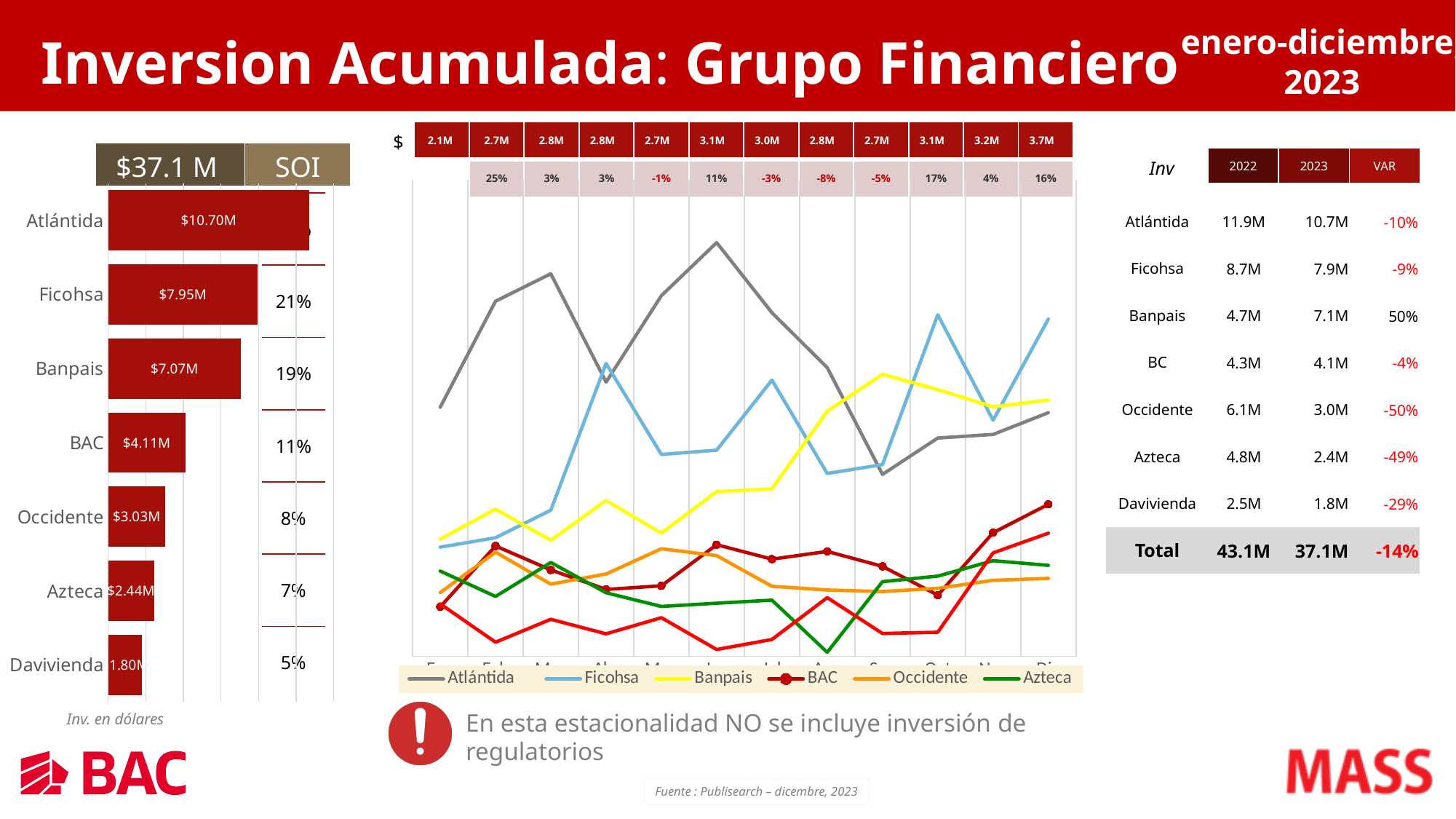
In the bar chart on the left, which is larger, the value for Banpais or the value for BAC? Banpais In the bar chart on the left, what SOI percentage is shown for Banpais? 19% In the bar chart on the left, which category has the highest value? Atlántida In the bar chart on the left, what is the difference between the values for Atlántida and Ficohsa? $2.75M How many categories are shown in the bar chart on the left? 7 What kind of chart is the chart in the middle of the slide? Line chart In the row of monthly totals above the line chart, what is the value shown for the last month (Dic)? 3.7M In the bar chart on the left, which category has the lowest value? Davivienda What kind of chart is the chart on the left of the slide? Bar chart How many series does the legend of the line chart in the middle list? 6 In the bar chart on the left, what is the value shown for Ficohsa? $7.95M In the line chart in the middle, which series has the highest value in March (Mar)? Atlántida